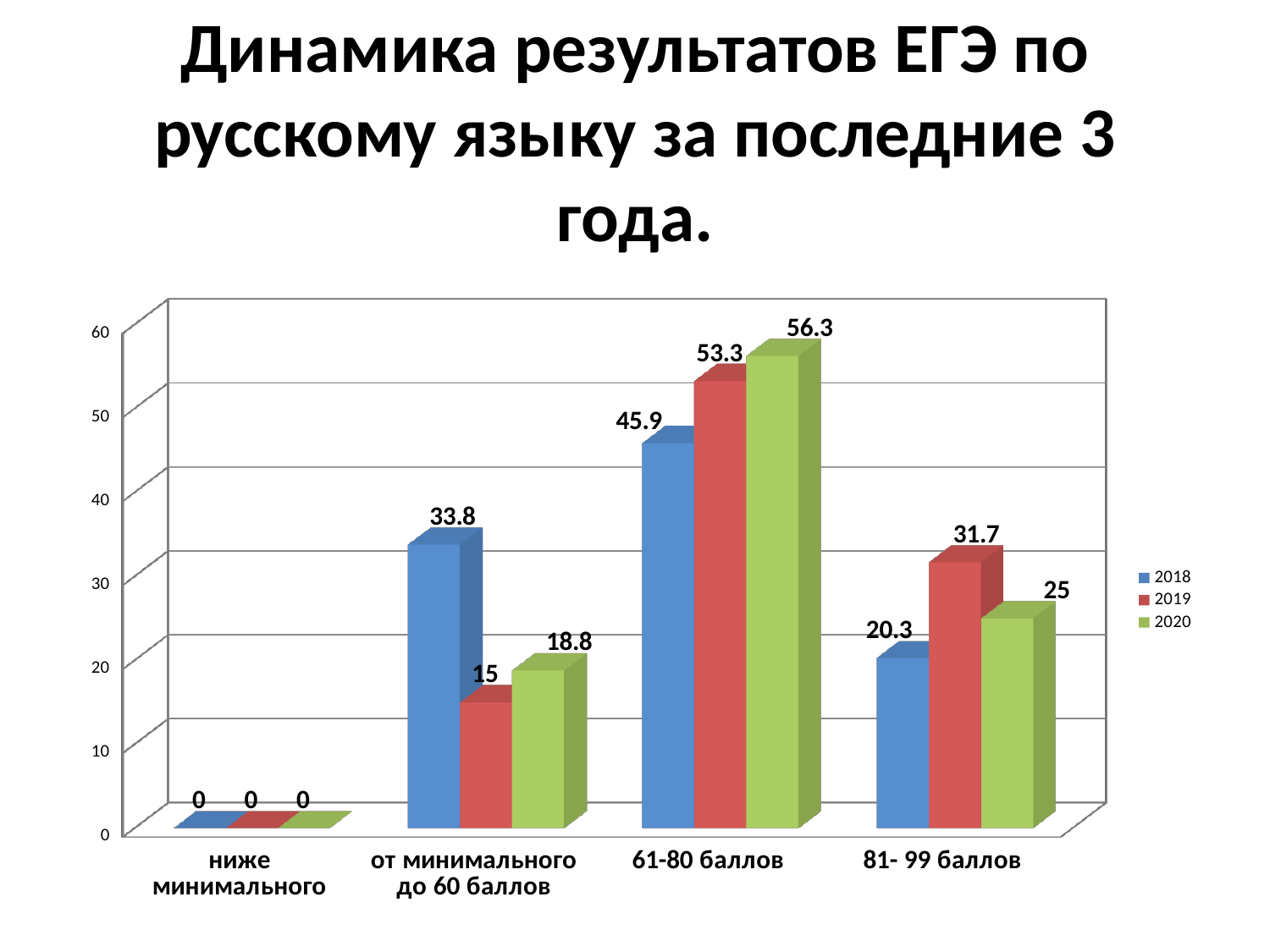
What is the difference between the 2020 and 2018 values in the '61-80 баллов' category? 10.4 Does the 2018 series rise or fall from 'от минимального до 60 баллов' to '61-80 баллов'? rise How many series does the legend list? 3 How many categories are shown on the x axis? 4 What kind of chart is shown on the slide? bar chart Which series is shown in green in the legend? 2020 Which category has the lowest value for the 2019 series? ниже минимального Which category has the highest value for the 2020 series? 61-80 баллов What is the value for 2019 in the '61-80 баллов' category? 53.3 Which is larger in the '81- 99 баллов' category: the 2019 value or the 2020 value? 2019 What is the value for 2018 in the 'от минимального до 60 баллов' category? 33.8 What is the value for 2020 in the '81- 99 баллов' category? 25